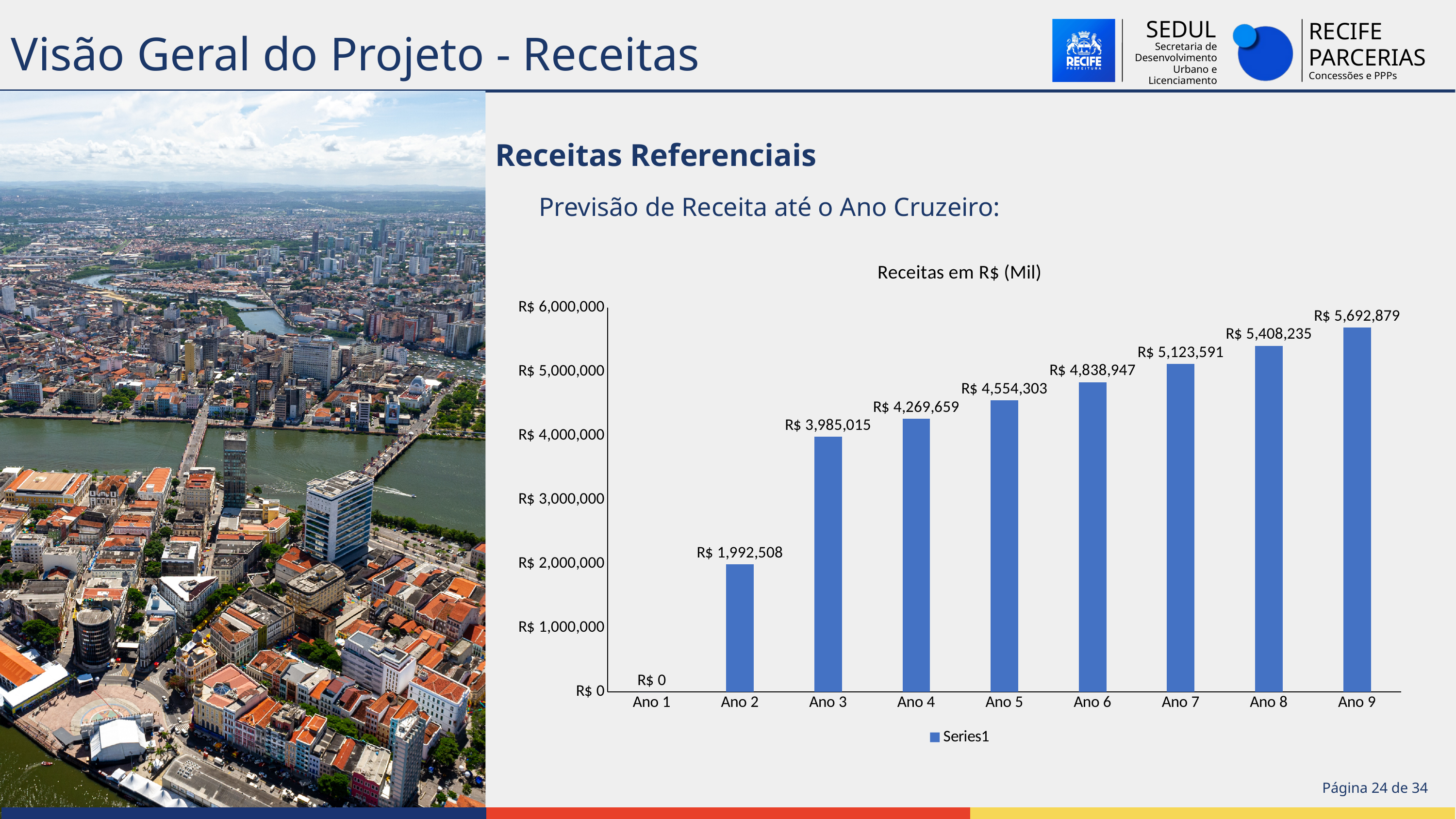
What is the value for Ano 2 in the chart? R$ 1,992,508 How many years (categories) are shown on the x axis of the chart? 9 What is the difference between the values for Ano 3 and Ano 2? R$ 1,992,507 Do the values rise or fall from Ano 1 to Ano 9? rise Which year has the lowest value in the chart? Ano 1 What is the value for Ano 9 in the chart? R$ 5,692,879 What is the difference between the values for Ano 9 and Ano 8? R$ 284,644 Which year has the highest value in the chart? Ano 9 What kind of chart is shown on the slide? bar chart Which is larger, the value for Ano 4 or the value for Ano 7? Ano 7 Is the value for Ano 6 greater or less than R$ 5,000,000? less What is the value for Ano 5 in the chart? R$ 4,554,303